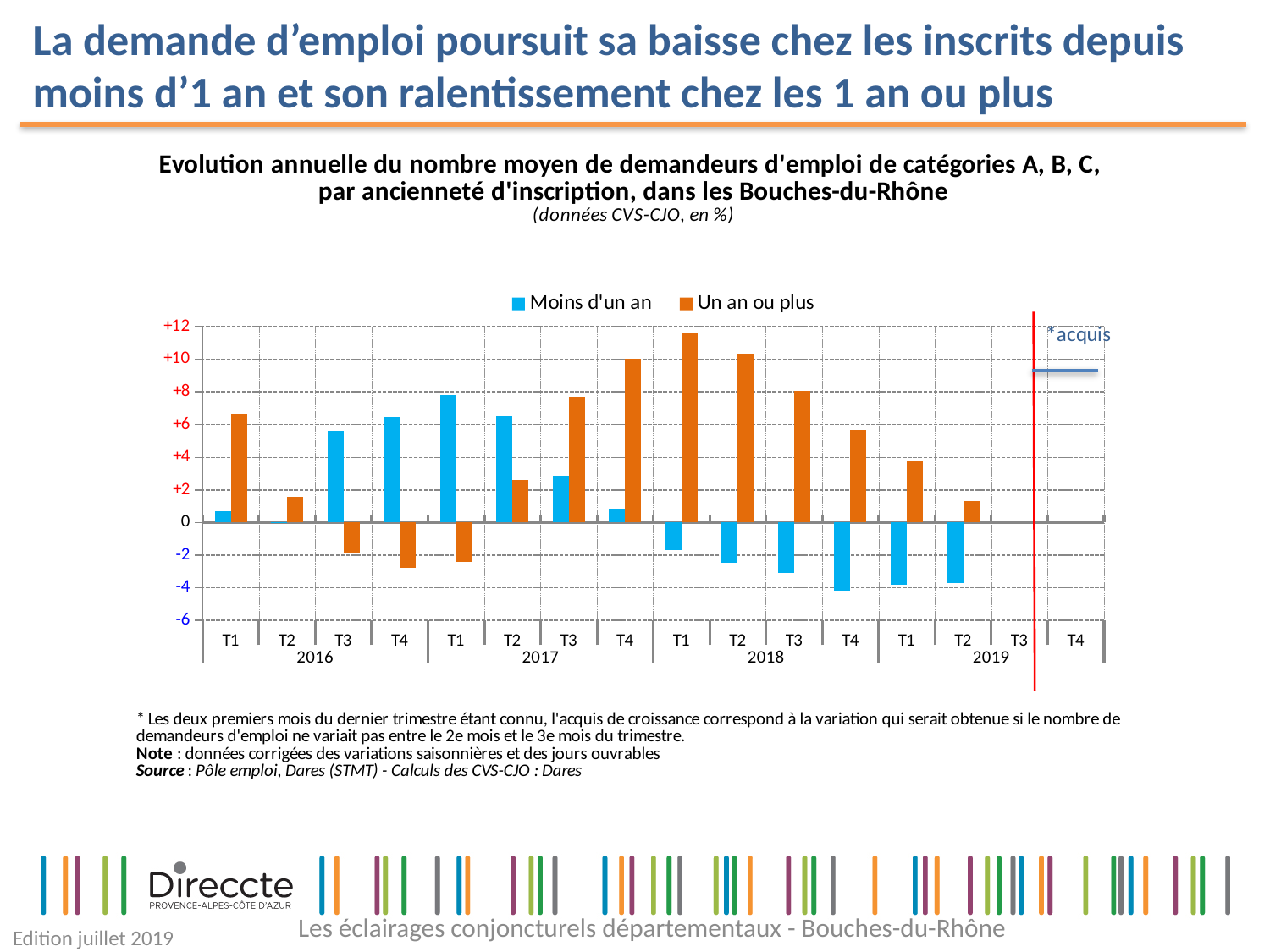
Which colour represents the series 'Un an ou plus'? orange What are the two series named in the legend? Moins d'un an; Un an ou plus Is the value for 'Un an ou plus' in T4 2018 greater or less than +4? greater Is the value for 'Un an ou plus' in T1 2018 greater or less than +10? greater Is the value for 'Moins d'un an' in T1 2017 greater or less than +6? greater In T1 2017, which series has the larger value, 'Moins d'un an' or 'Un an ou plus'? Moins d'un an In which quarter does the 'Moins d'un an' series reach its highest value? T1 2017 What kind of chart is shown on the slide? bar chart Does the 'Un an ou plus' series rise or fall from T1 2018 to T2 2019? fall How many series does the legend list? 2 In T1 2018, which series has the larger value, 'Moins d'un an' or 'Un an ou plus'? Un an ou plus In which quarter does the 'Un an ou plus' series reach its highest value? T1 2018